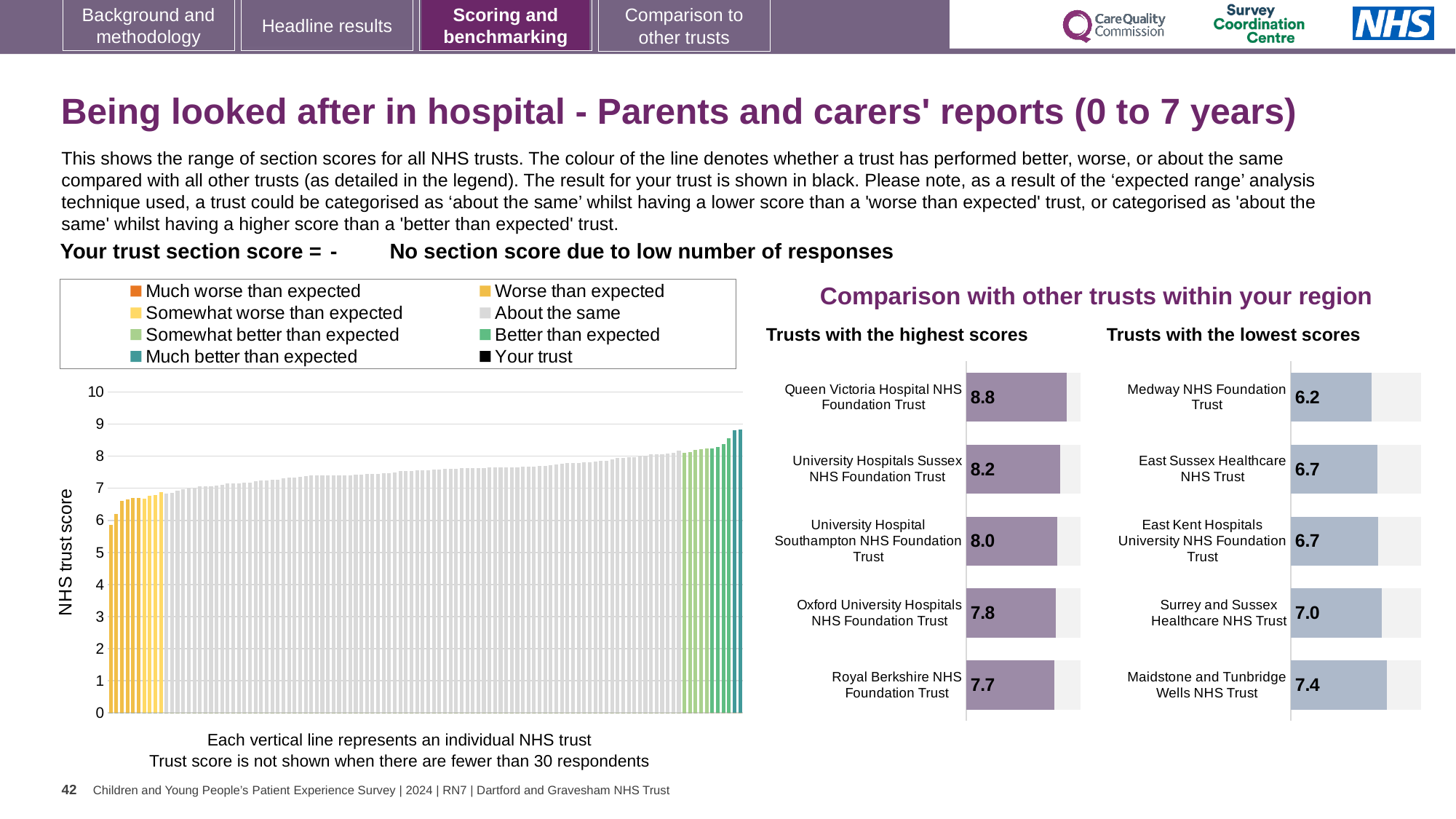
In the 'Trusts with the lowest scores' chart, what is the difference between the scores of Surrey and Sussex Healthcare NHS Trust and Medway NHS Foundation Trust? 0.8 In the main 'NHS trust score' chart, is the tallest bar greater or less than 9? less What kind of chart is the main 'NHS trust score' chart on the left of the slide? Bar chart In the 'Trusts with the lowest scores' chart, which trust has the lowest score? Medway NHS Foundation Trust In the 'Trusts with the highest scores' chart, what is the difference between the scores of Queen Victoria Hospital NHS Foundation Trust and Royal Berkshire NHS Foundation Trust? 1.1 In the 'Trusts with the highest scores' chart, what is the score for Queen Victoria Hospital NHS Foundation Trust? 8.8 How many entries does the legend of the main 'NHS trust score' chart list? 8 In the 'Trusts with the lowest scores' chart, what is the score for Medway NHS Foundation Trust? 6.2 In the 'Trusts with the highest scores' chart, which trust has the highest score? Queen Victoria Hospital NHS Foundation Trust In the main 'NHS trust score' chart, do the bars rise or fall from left to right? Rise Which has the higher score: Oxford University Hospitals NHS Foundation Trust in the highest-scores chart or Maidstone and Tunbridge Wells NHS Trust in the lowest-scores chart? Oxford University Hospitals NHS Foundation Trust How many trusts are shown in the 'Trusts with the highest scores' chart? 5